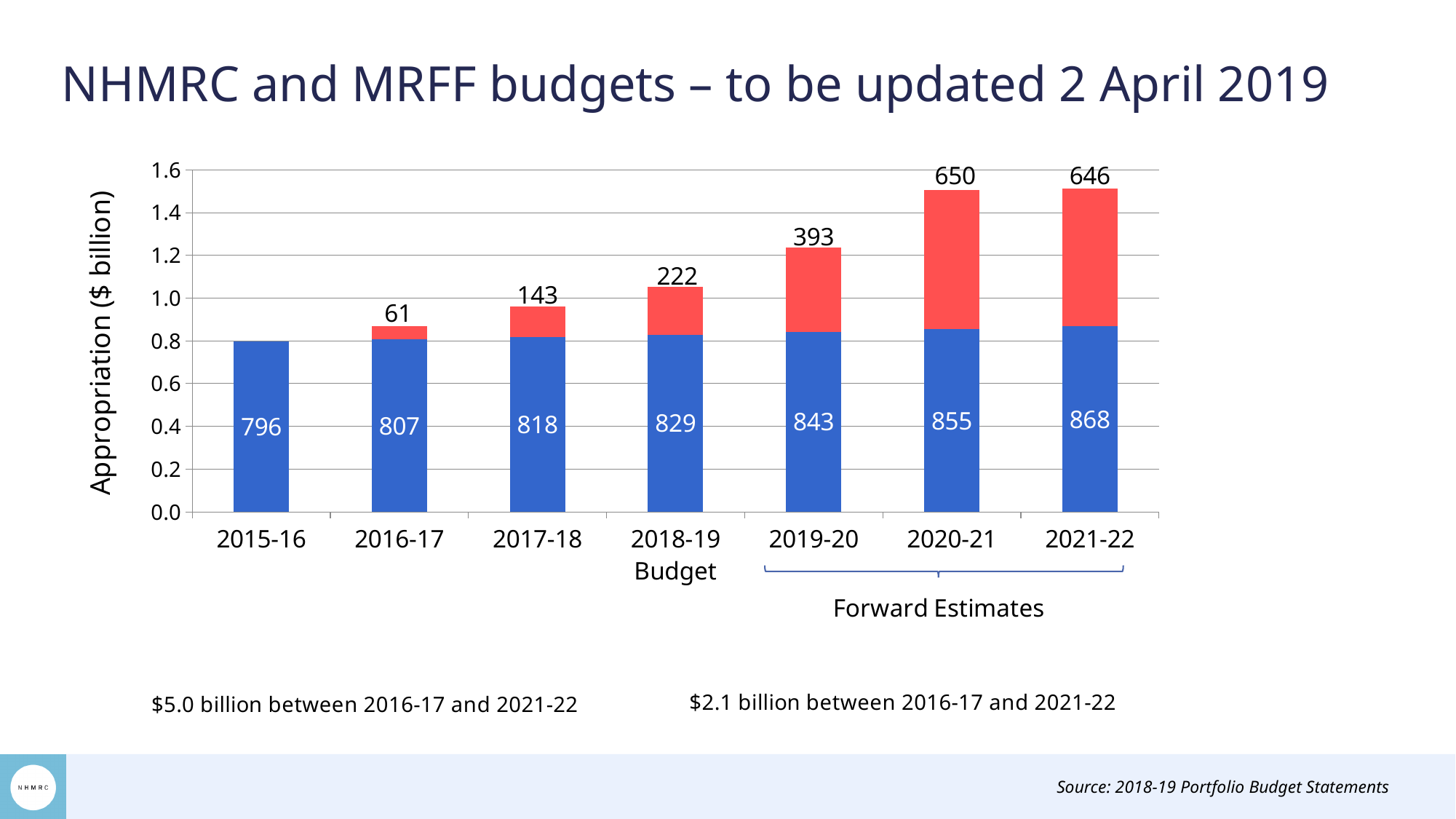
What is the total of the two printed values on the 2021-22 bar? 1514 What is the value printed on the red segment of the 2019-20 bar? 393 How many years are shown on the x axis? 7 Do the blue segment values rise or fall from 2015-16 to 2021-22? Rise Is the height of the 2015-16 bar greater or less than 1.0 on the y axis? less What kind of chart is shown on the slide? Stacked bar chart Which year has the larger red segment value, 2020-21 or 2021-22? 2020-21 What is the value printed on the blue segment of the 2018-19 bar? 829 Is the total height of the 2019-20 bar greater or less than 1.2 on the y axis? greater Which year has the lowest value for the blue segment? 2015-16 What is the difference between the blue segment values for 2021-22 and 2015-16? 72 Which year has the highest value for the red segment? 2020-21